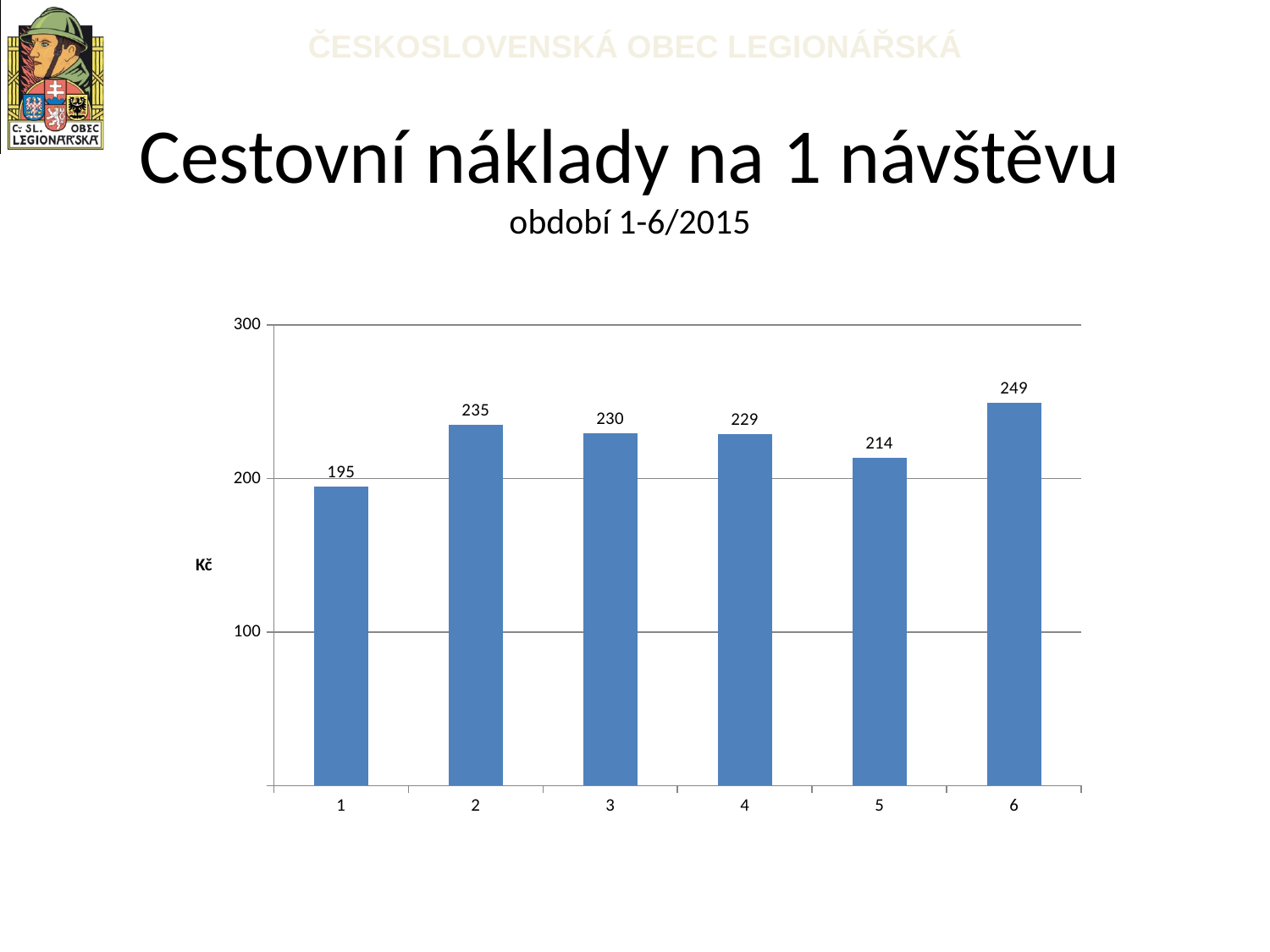
Which is larger, the value for category 2 or the value for category 5? category 2 What is the difference between the values for category 2 and category 5? 21 What is the value for category 5? 214 How many categories are shown on the x axis? 6 Is the value for category 1 greater or less than 200? less What is the value for category 6? 249 Which category has the highest value? 6 What is the difference between the values for category 6 and category 1? 54 What is the value for category 1? 195 Which category has the lowest value? 1 What unit label is shown on the vertical axis? Kč What kind of chart is shown on the slide? bar chart